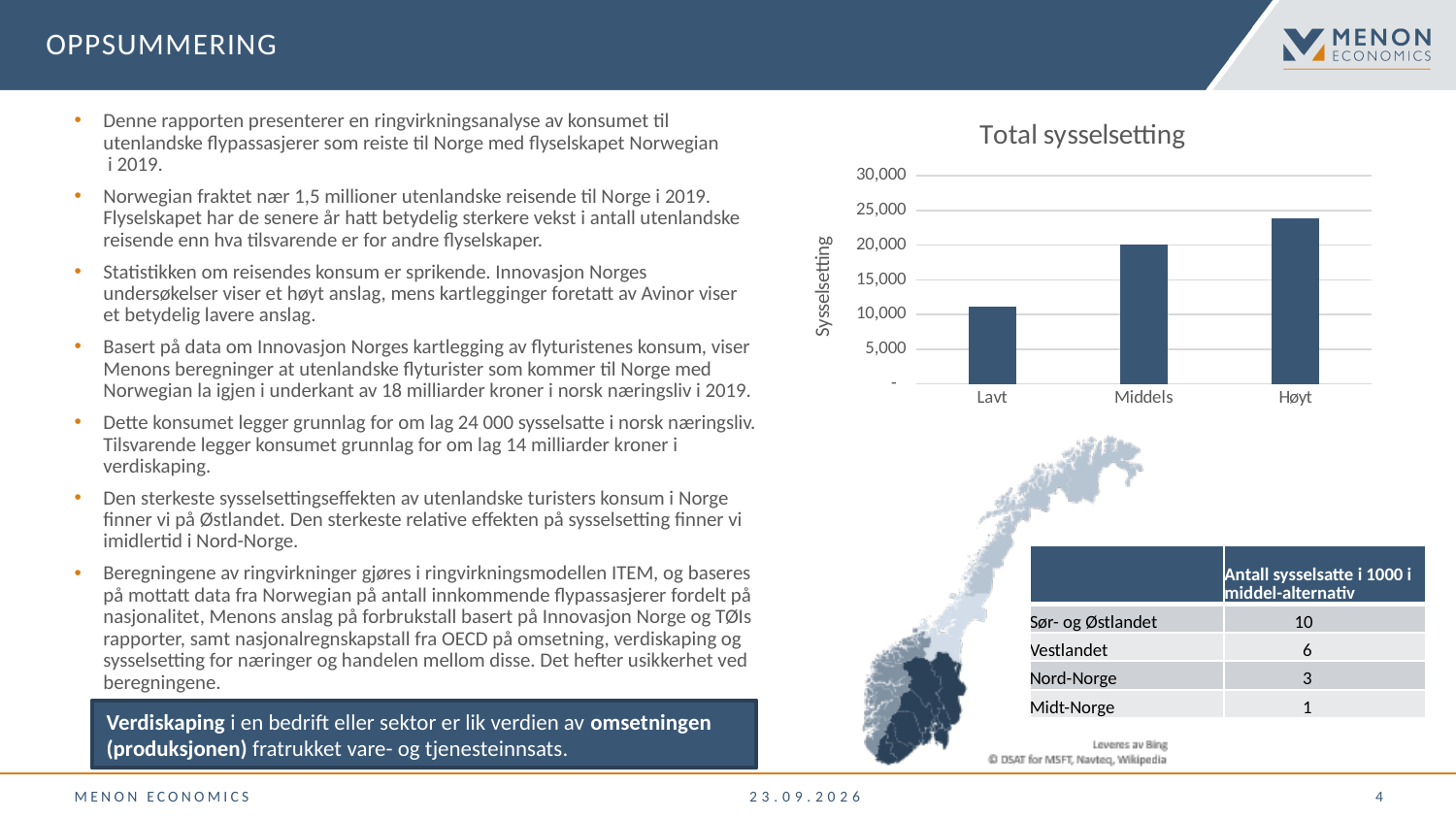
How many categories are shown on the x axis of the "Total sysselsetting" chart? 3 In the "Total sysselsetting" chart, is the value for Lavt greater or less than 5,000? greater In the "Total sysselsetting" chart, is the value for Middels greater or less than 25,000? less Which category has the highest value in the "Total sysselsetting" chart? Høyt Do the values in the "Total sysselsetting" chart rise or fall from Lavt to Høyt? rise What kind of chart is the "Total sysselsetting" chart? bar chart In the "Total sysselsetting" chart, is the value for Lavt greater or less than 15,000? less Which category has the lowest value in the "Total sysselsetting" chart? Lavt What is the title of the chart on the slide? Total sysselsetting In the "Total sysselsetting" chart, which is larger, the value for Middels or the value for Lavt? Middels What is the label on the vertical axis of the "Total sysselsetting" chart? Sysselsetting